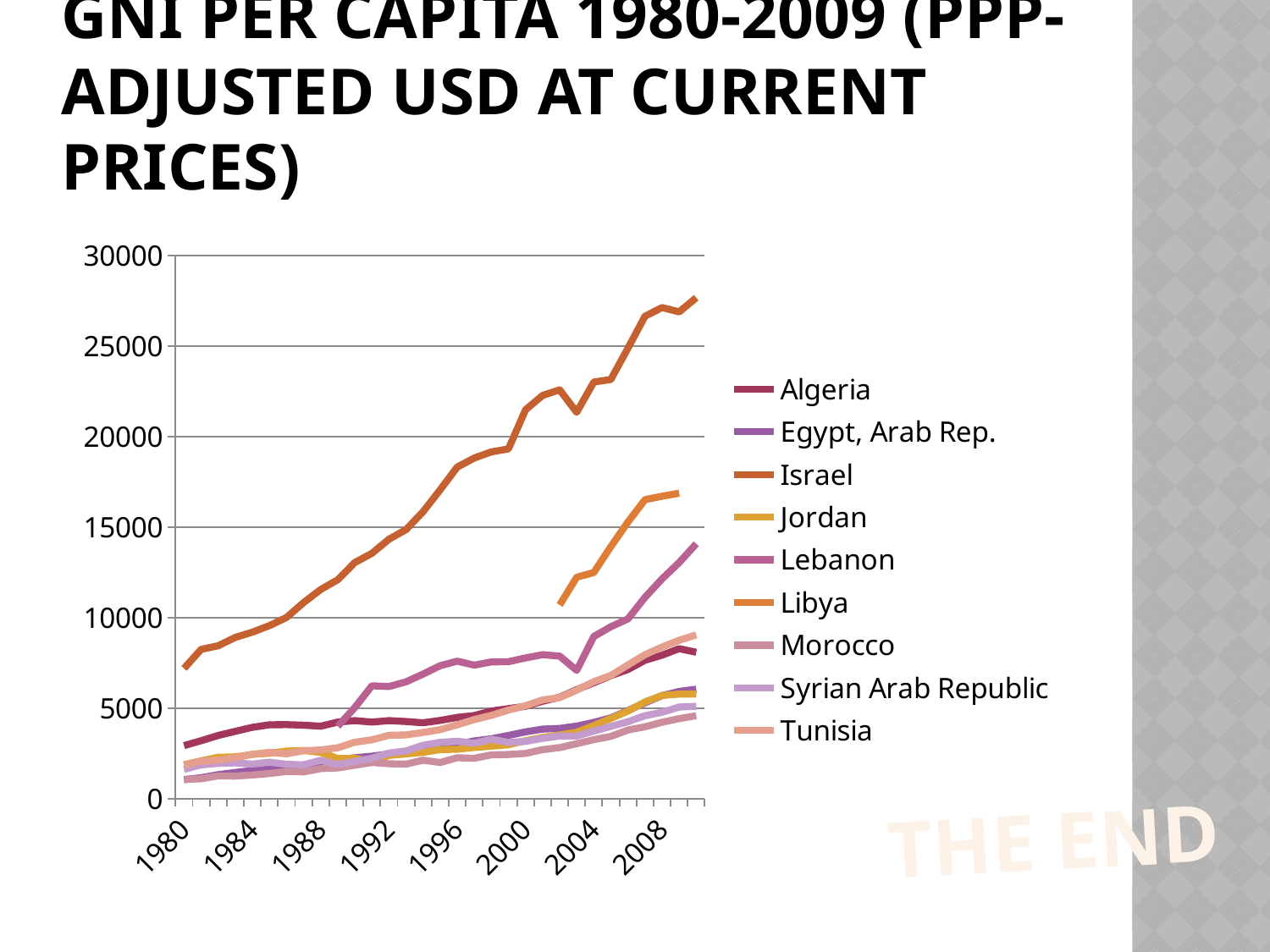
Is the value for Libya at the end of the series (2009) greater or less than 15000? greater Is the value for Lebanon at the end of the series (2009) greater or less than 15000? less Is the value for Israel in 1980 greater or less than 5000? greater What is the title of the chart? GNI PER CAPITA 1980-2009 (PPP-ADJUSTED USD AT CURRENT PRICES) Does Israel's GNI per capita generally rise or fall from 1980 to 2009? rise In 2008, which is larger, the value for Israel or the value for Libya? Israel Which country has the highest GNI per capita throughout the period shown? Israel In 2009, which is larger, the value for Lebanon or the value for Algeria? Lebanon How many series does the legend list? 9 What kind of chart is shown on the slide? line chart